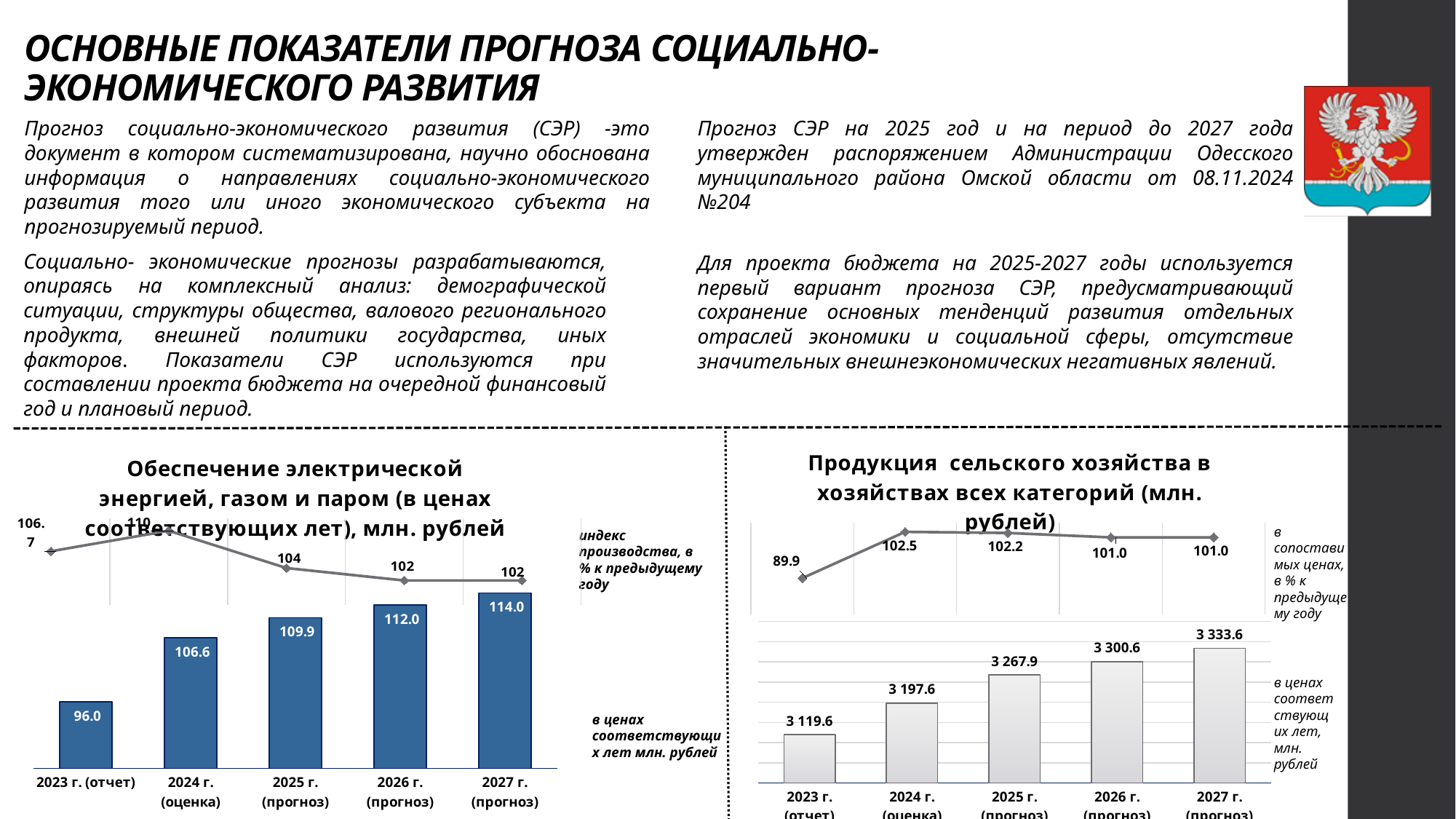
How many years (categories) are shown in the chart 'Продукция сельского хозяйства в хозяйствах всех категорий'? 5 In the chart 'Продукция сельского хозяйства в хозяйствах всех категорий', which line value is larger: 2024 г. (оценка) or 2026 г. (прогноз)? 2024 г. (оценка) In the chart 'Обеспечение электрической энергией, газом и паром', do the bar values rise or fall from 2023 to 2027? rise In the chart 'Продукция сельского хозяйства в хозяйствах всех категорий', what is the line value for 2023 г. (отчет)? 89.9 What kind of chart is 'Обеспечение электрической энергией, газом и паром'? combined bar and line chart In the chart 'Обеспечение электрической энергией, газом и паром', what is the bar value for 2023 г. (отчет)? 96.0 In the chart 'Обеспечение электрической энергией, газом и паром', what is the difference between the bar values for 2024 г. (оценка) and 2023 г. (отчет)? 10.6 In the chart 'Обеспечение электрической энергией, газом и паром', what is the bar value for 2027 г. (прогноз)? 114.0 In the chart 'Продукция сельского хозяйства в хозяйствах всех категорий', which year has the highest bar value? 2027 г. (прогноз) In the chart 'Обеспечение электрической энергией, газом и паром', what is the index line value for 2025 г. (прогноз)? 104 In the chart 'Продукция сельского хозяйства в хозяйствах всех категорий', what is the bar value for 2025 г. (прогноз)? 3 267.9 In the chart 'Обеспечение электрической энергией, газом и паром', which year has the lowest bar value? 2023 г. (отчет)